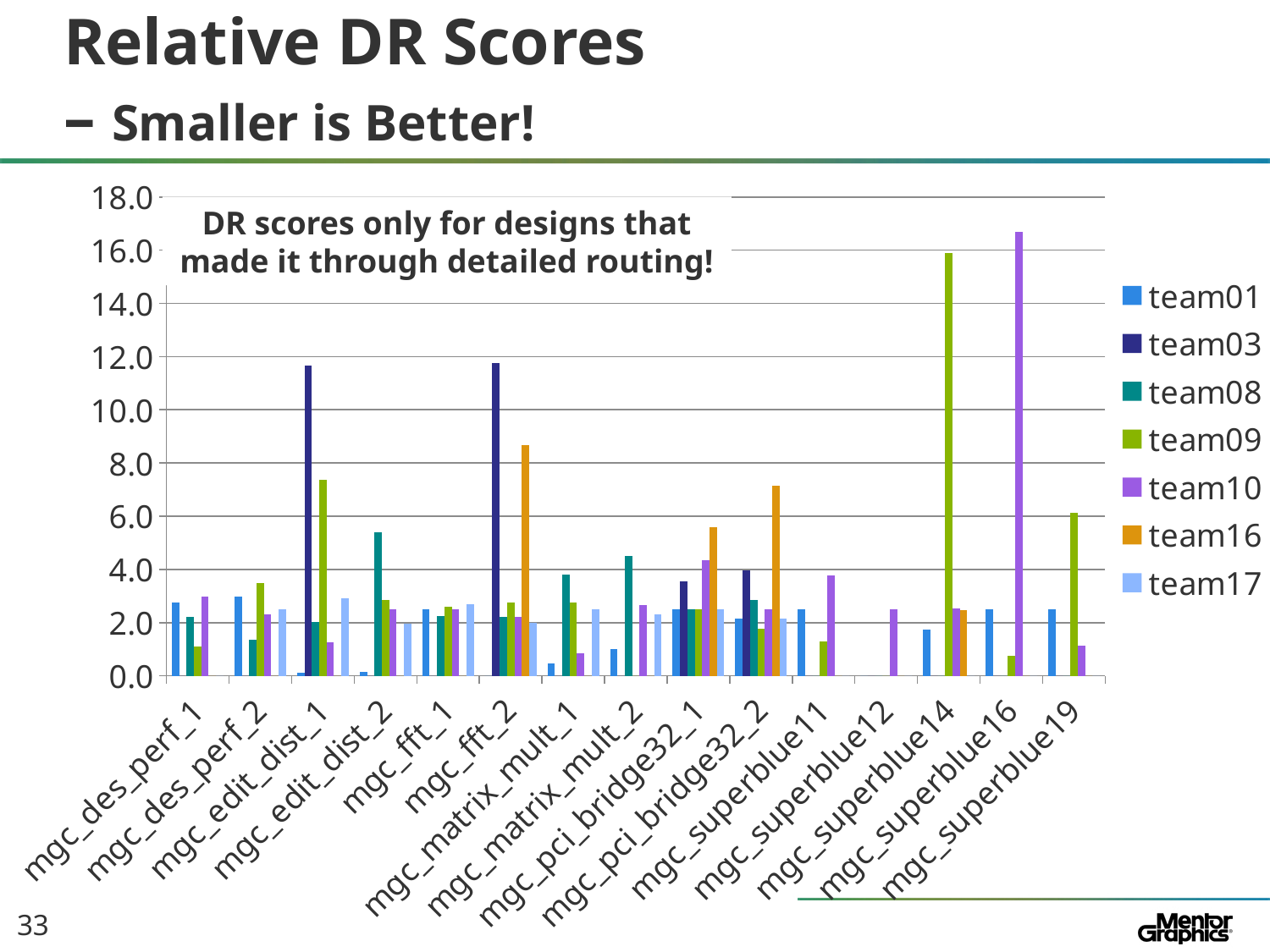
How many design categories are shown along the x axis? 15 What is the highest value shown on the y axis? 18.0 Is the value for team08 at mgc_edit_dist_2 greater or less than 4.0? greater Which team has the highest bar for mgc_superblue16? team10 Which team has the highest bar for mgc_edit_dist_1? team03 Which team has the highest bar for mgc_superblue14? team09 What kind of chart is shown on the slide? bar chart For mgc_pci_bridge32_1, which is larger: the value for team16 or the value for team10? team16 Is the value for team09 at mgc_superblue14 greater or less than 14.0? greater How many series does the legend list? 7 Is the value for team03 at mgc_edit_dist_1 greater or less than 10.0? greater